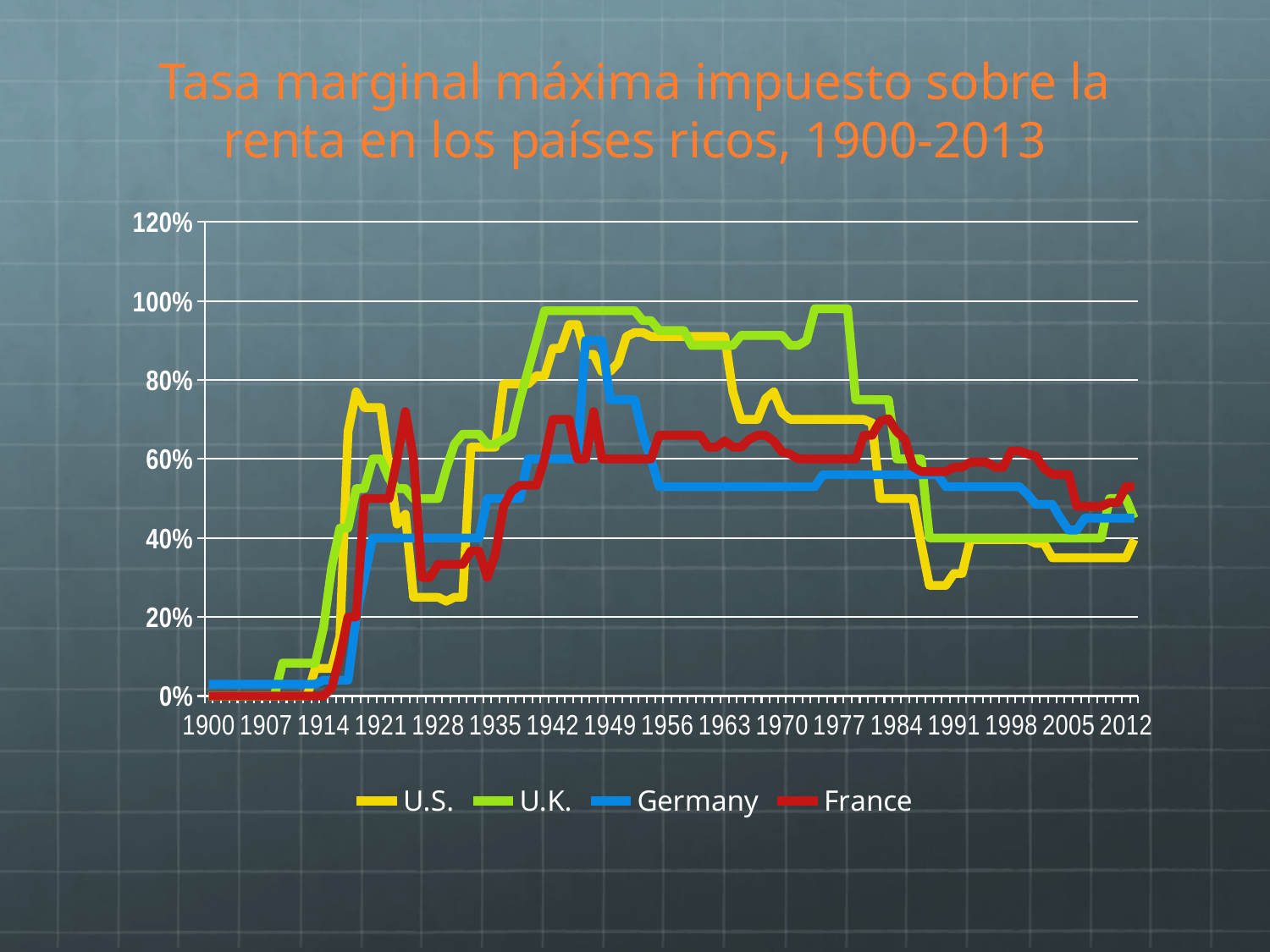
Is the value for Germany around 1963 greater or less than 60%? less Is the value for France around 1900 greater or less than 20%? less Is the value for U.S. around 1991 greater or less than 40%? less Around 1991, which series is higher, U.S. or Germany? Germany Around 1977, which series is higher, U.K. or Germany? U.K. Which series has the lowest value around 1991? U.S. How many series does the legend list? 4 Which colour is used for the Germany series? Blue What kind of chart is shown on the slide? Line chart Does the U.S. series rise or fall between 1984 and 1991? Fall What is the title of the chart? Tasa marginal máxima impuesto sobre la renta en los países ricos, 1900-2013